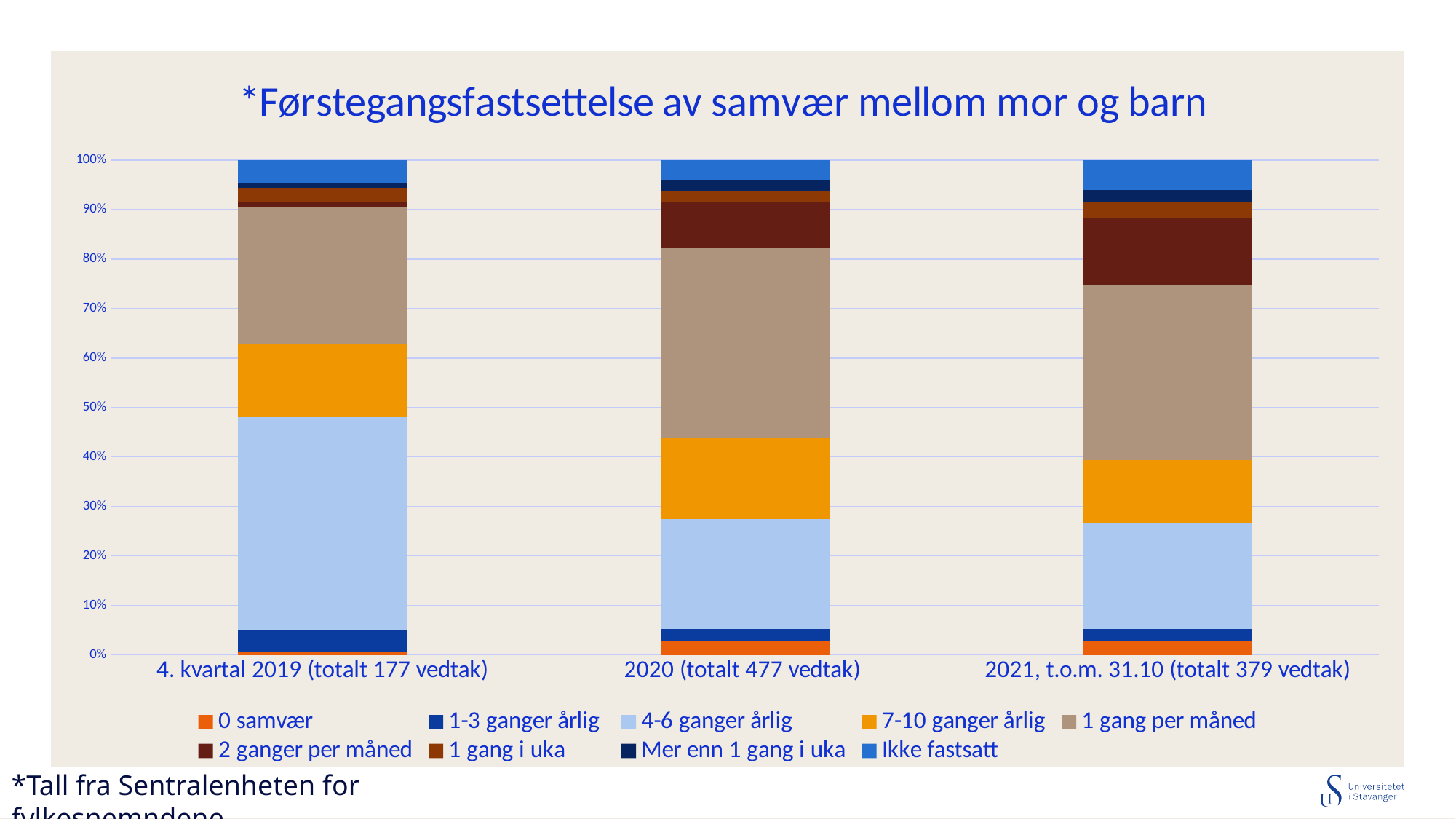
What is the title of the chart? *Førstegangsfastsettelse av samvær mellom mor og barn Is the share for '4-6 ganger årlig' in '2020 (totalt 477 vedtak)' greater or less than 30%? less Which category has the largest share for '2 ganger per måned'? 2021, t.o.m. 31.10 (totalt 379 vedtak) What kind of chart is shown on the slide? Stacked bar chart How many series does the legend list? 9 Which category has the largest share for '4-6 ganger årlig'? 4. kvartal 2019 (totalt 177 vedtak) How many categories (bars) are shown on the x axis? 3 Is the share for '4-6 ganger årlig' in '4. kvartal 2019 (totalt 177 vedtak)' greater or less than 40%? greater Which is larger: the share for '2 ganger per måned' in '4. kvartal 2019 (totalt 177 vedtak)' or in '2021, t.o.m. 31.10 (totalt 379 vedtak)'? 2021, t.o.m. 31.10 (totalt 379 vedtak) What does each stacked bar total? 100% Does the share for '4-6 ganger årlig' rise or fall from the 2019 bar to the 2021 bar? fall Is the share for '1 gang per måned' in '2020 (totalt 477 vedtak)' greater or less than 30%? greater